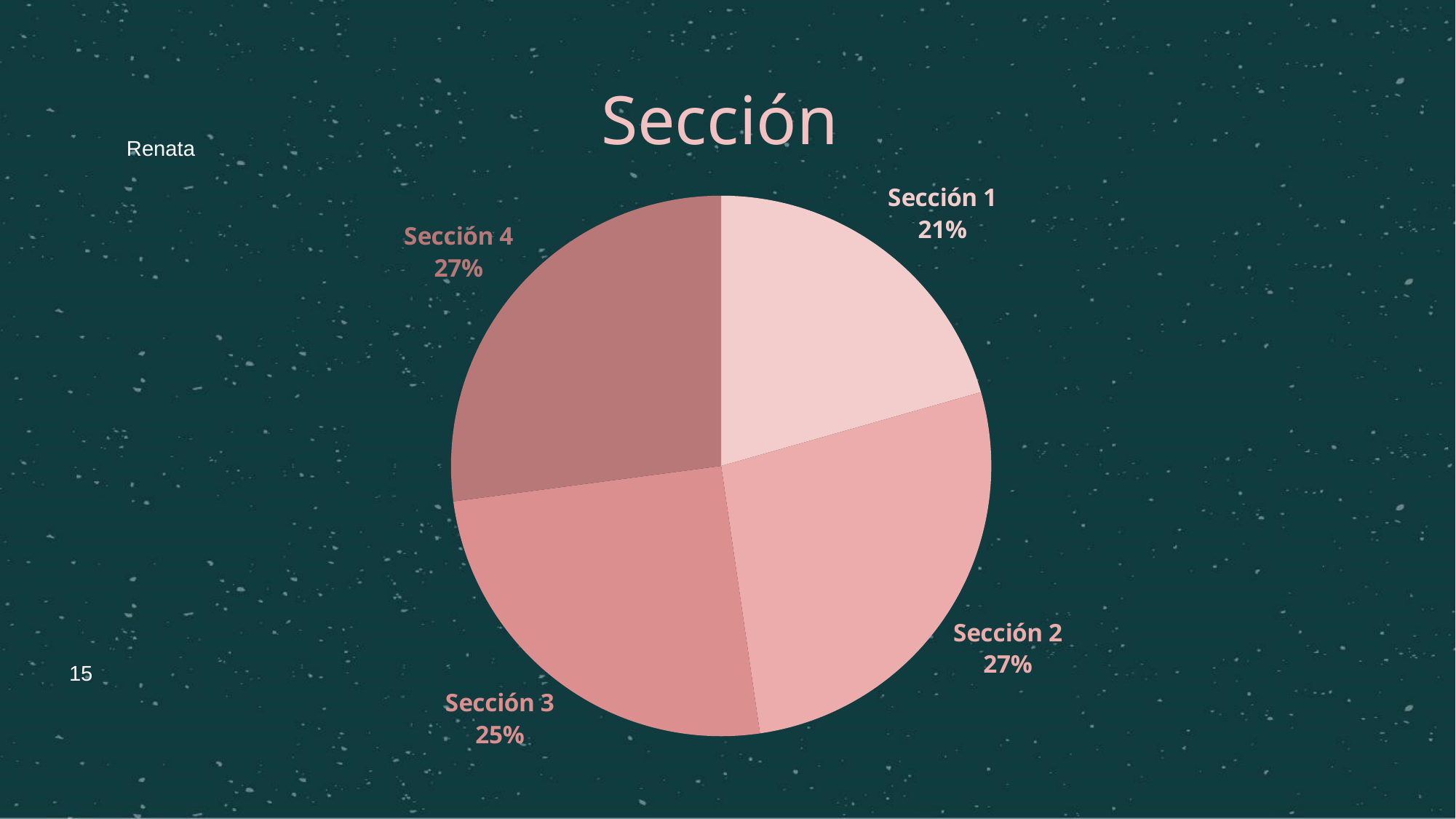
Which section has the smallest share of the pie? Sección 1 Which two sections have the same share of the pie? Sección 2 and Sección 4 What percentage does Sección 3 represent? 25% What percentage does Sección 1 represent? 21% What is the difference in percentage points between Sección 4 and Sección 1? 6 What percentage does Sección 2 represent? 27% What percentage does Sección 4 represent? 27% What is the difference in percentage points between Sección 2 and Sección 3? 2 What type of chart is shown on the slide? Pie chart What is the title of the chart? Sección Which is larger, the share of Sección 3 or the share of Sección 1? Sección 3 How many slices does the pie chart have? 4